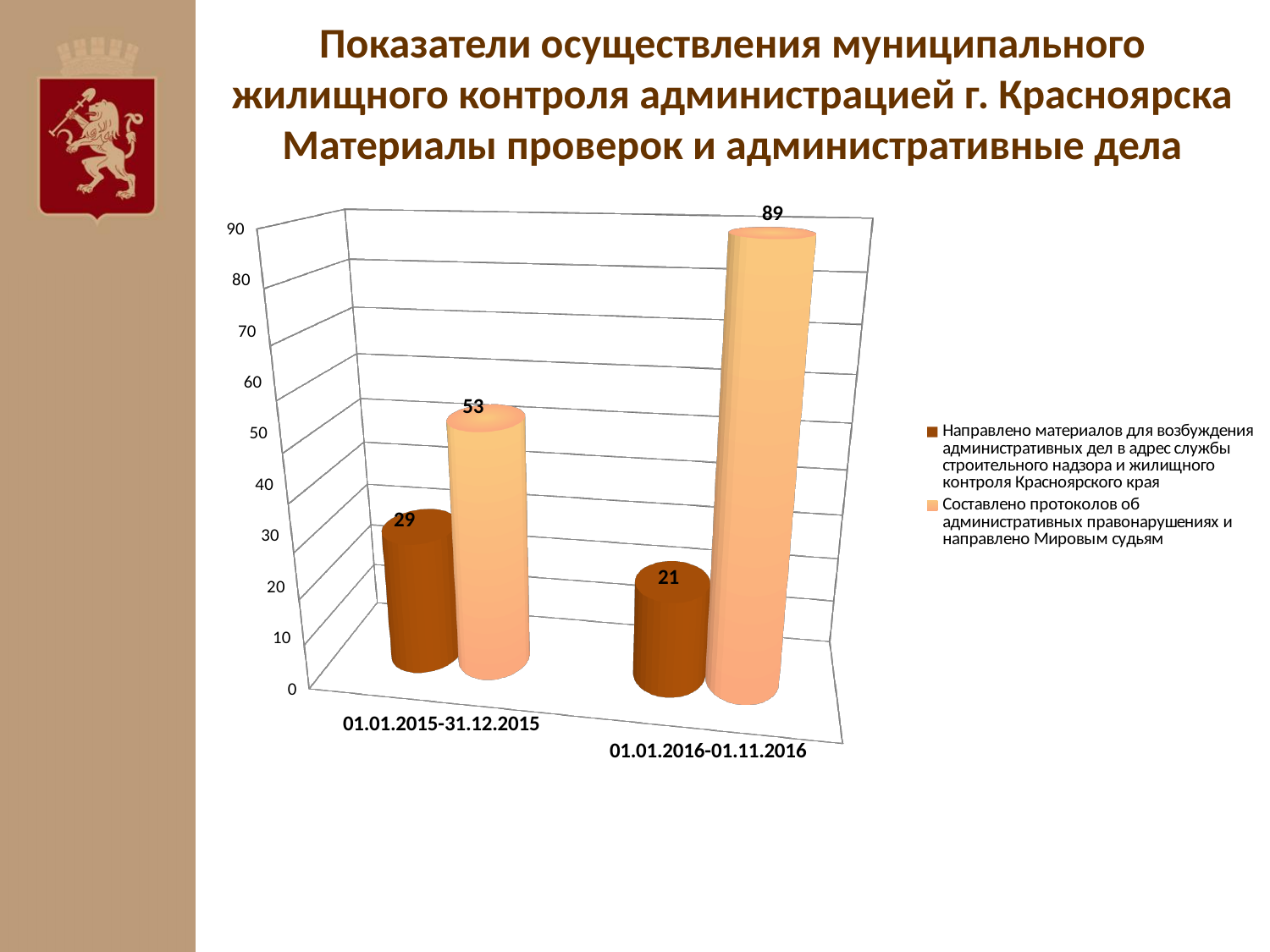
What is the value for 'Направлено материалов для возбуждения административных дел...' in the period 01.01.2016-01.11.2016? 21 What is the difference between the 'Направлено материалов...' values for 01.01.2015-31.12.2015 and 01.01.2016-01.11.2016? 8 How many series does the legend list? 2 Which period has the highest value for 'Составлено протоколов об административных правонарушениях...'? 01.01.2016-01.11.2016 What kind of chart is shown on the slide? Bar chart Which is larger in the period 01.01.2015-31.12.2015: 'Направлено материалов...' or 'Составлено протоколов...'? Составлено протоколов... What is the difference between the 'Составлено протоколов...' values for 01.01.2016-01.11.2016 and 01.01.2015-31.12.2015? 36 Which period has the lowest value for 'Направлено материалов для возбуждения административных дел...'? 01.01.2016-01.11.2016 What is the value for 'Составлено протоколов об административных правонарушениях...' in the period 01.01.2016-01.11.2016? 89 How many periods (categories) are shown on the x axis? 2 What is the value for 'Направлено материалов для возбуждения административных дел...' in the period 01.01.2015-31.12.2015? 29 What is the value for 'Составлено протоколов об административных правонарушениях...' in the period 01.01.2015-31.12.2015? 53